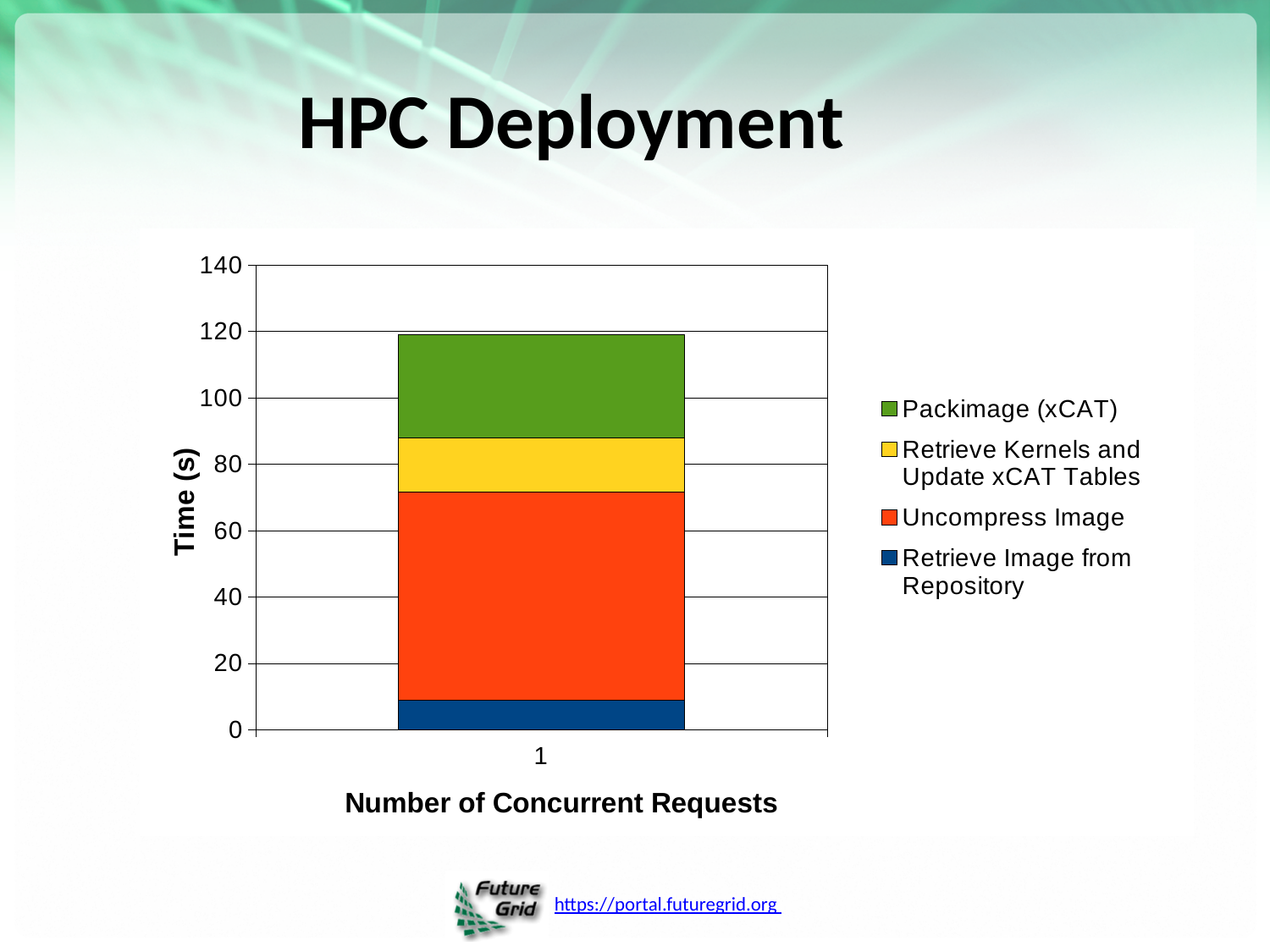
Is the Retrieve Image from Repository segment of the bar greater or less than 20 seconds? less How many series does the legend list? 4 Is the total height of the stacked bar greater or less than 100? greater Which segment of the stacked bar is the smallest? Retrieve Image from Repository Which series is shown at the top of the stacked bar? Packimage (xCAT) Which segment of the stacked bar is the largest? Uncompress Image How many categories are shown on the x axis? 1 What kind of chart is shown on the slide? Stacked bar chart What is the label of the x axis? Number of Concurrent Requests Which segment is larger, Uncompress Image or Packimage (xCAT)? Uncompress Image Which segment is larger, Packimage (xCAT) or Retrieve Kernels and Update xCAT Tables? Packimage (xCAT) What is the label of the y axis? Time (s)